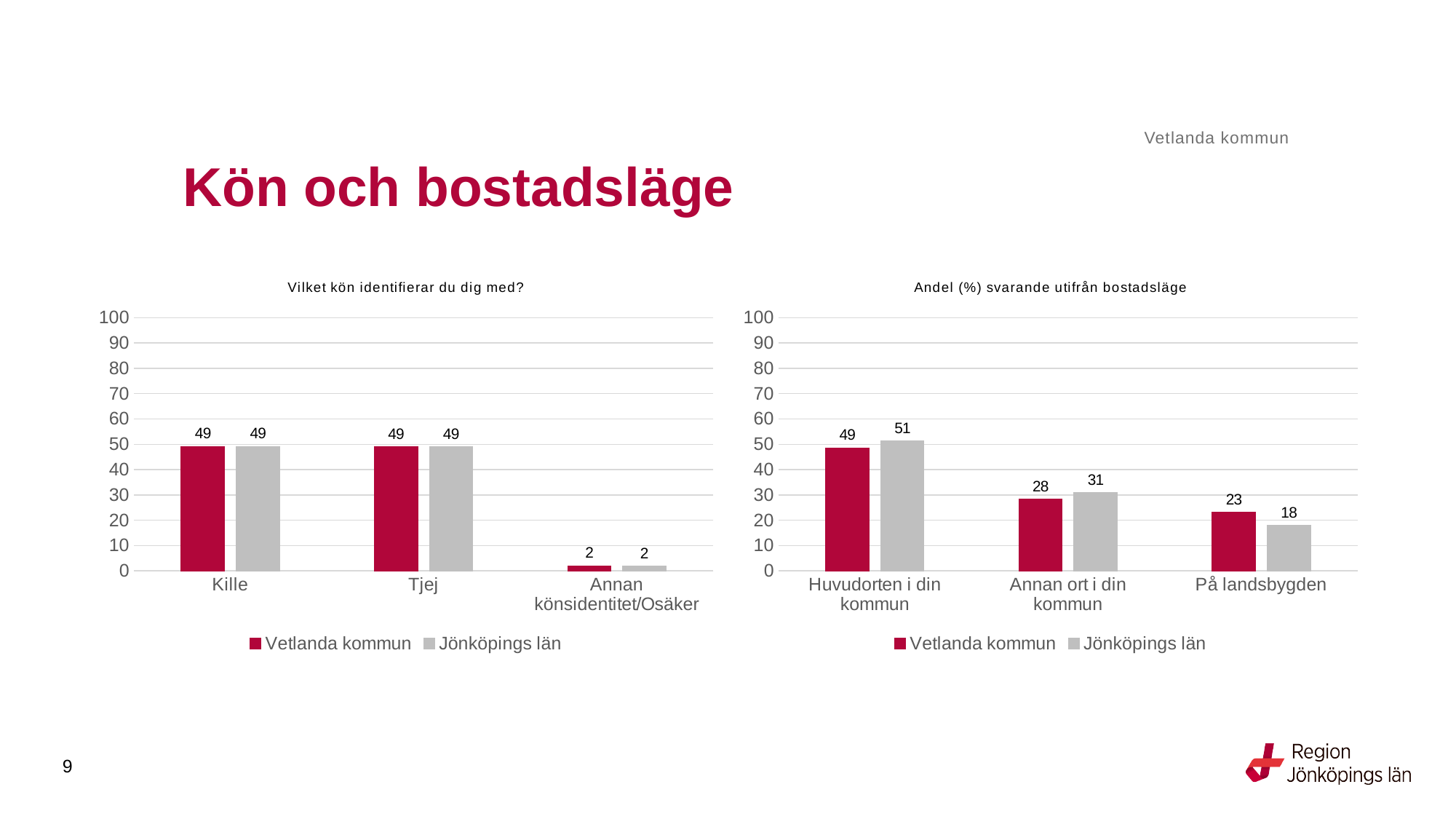
In the chart 'Andel (%) svarande utifrån bostadsläge', what is the value for Vetlanda kommun for På landsbygden? 23 In the chart 'Vilket kön identifierar du dig med?', how many categories are shown on the x axis? 3 In the chart 'Vilket kön identifierar du dig med?', what is the difference between the Vetlanda kommun values for Kille and Annan könsidentitet/Osäker? 47 In the chart 'Andel (%) svarande utifrån bostadsläge', what is the value for Jönköpings län for Huvudorten i din kommun? 51 In the chart 'Vilket kön identifierar du dig med?', which category has the lowest value for Vetlanda kommun? Annan könsidentitet/Osäker In the chart 'Andel (%) svarande utifrån bostadsläge', which category has the highest value for Vetlanda kommun? Huvudorten i din kommun In the chart 'Vilket kön identifierar du dig med?', what is the value for Vetlanda kommun for Kille? 49 In the chart 'Andel (%) svarande utifrån bostadsläge', what is the difference between Jönköpings län and Vetlanda kommun for Annan ort i din kommun? 3 What kind of chart is 'Andel (%) svarande utifrån bostadsläge'? Bar chart In the chart 'Vilket kön identifierar du dig med?', what is the value for Jönköpings län for Annan könsidentitet/Osäker? 2 In the chart 'Andel (%) svarande utifrån bostadsläge', which is larger for På landsbygden: Vetlanda kommun or Jönköpings län? Vetlanda kommun In the chart 'Andel (%) svarande utifrån bostadsläge', how many series does the legend list? 2